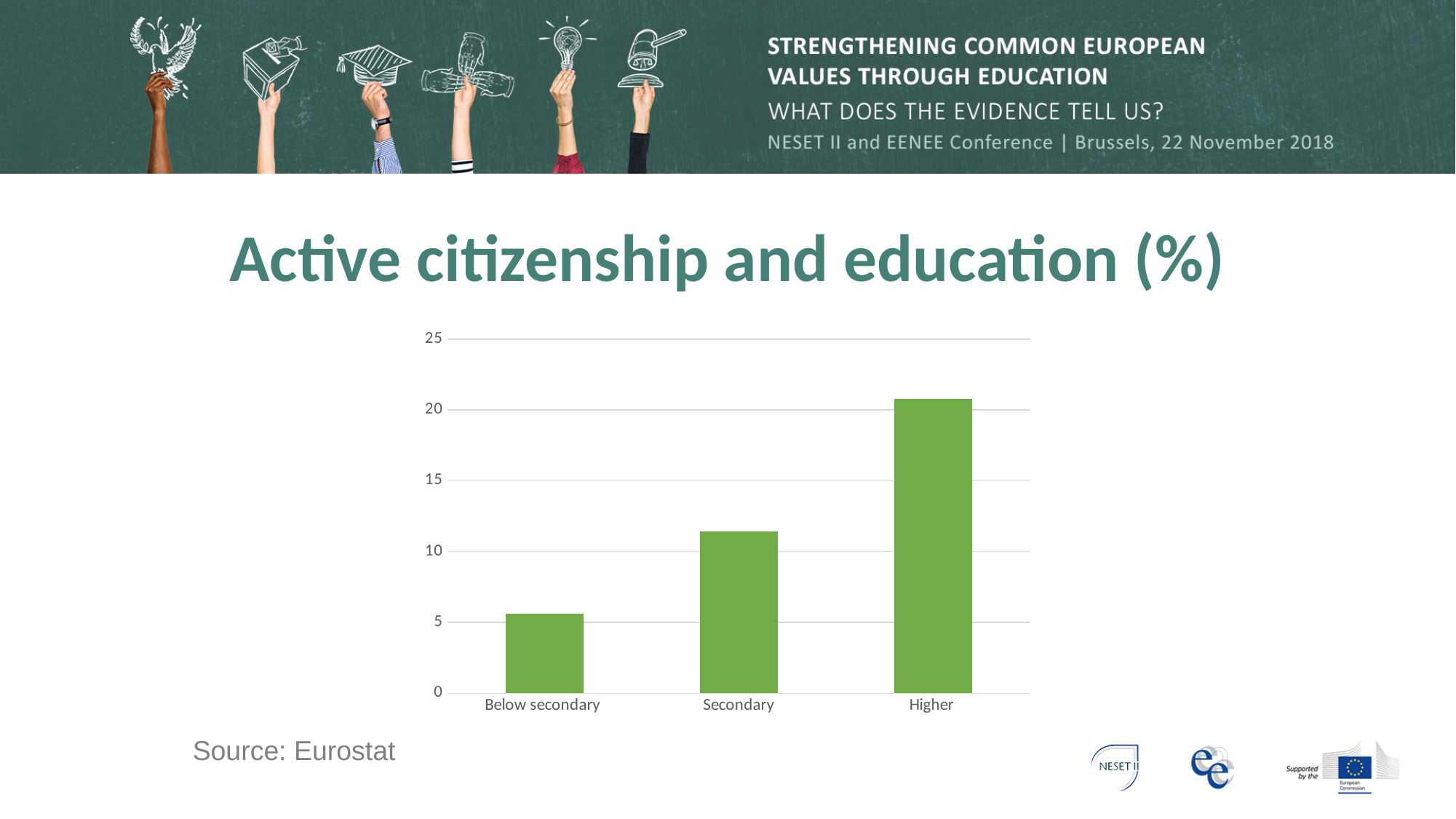
Which education level has the highest value in the chart? Higher How many categories are shown on the x axis of the chart? 3 Is the value for Secondary greater or less than 10? greater Which education level has the lowest value in the chart? Below secondary What source is cited for the chart data? Eurostat Do the values rise or fall from Below secondary to Higher along the x axis? rise Is the value for Below secondary greater or less than 10? less Is the value for Higher greater or less than 20? greater What is the title of the chart on the slide? Active citizenship and education (%) What kind of chart is shown on the slide? bar chart Which is larger, the value for Secondary or the value for Higher? Higher